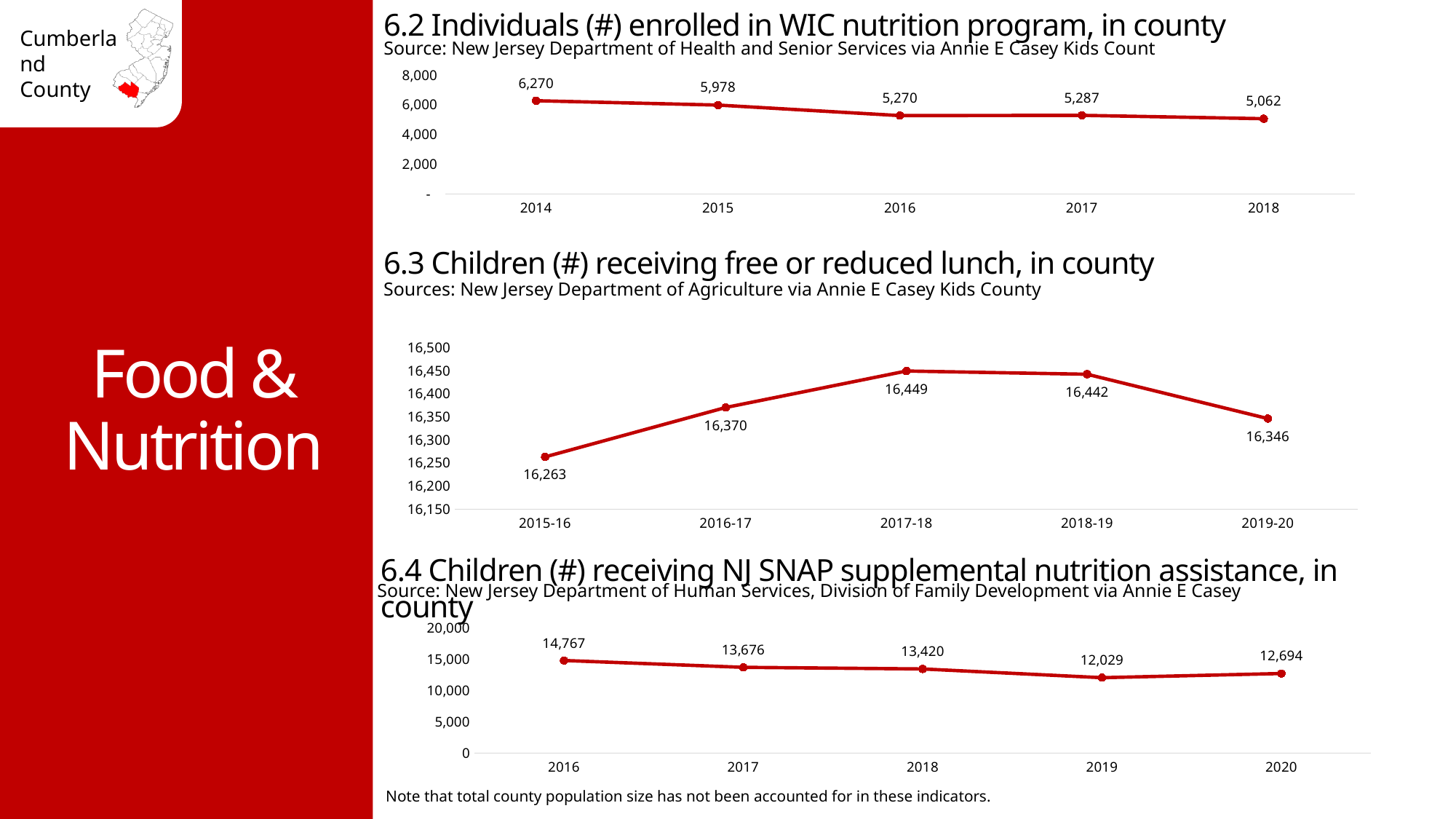
What kind of chart is '6.3 Children (#) receiving free or reduced lunch, in county'? Line chart In the chart '6.2 Individuals (#) enrolled in WIC nutrition program, in county', what is the value for 2014? 6,270 In the chart '6.3 Children (#) receiving free or reduced lunch, in county', what is the value for 2017-18? 16,449 In the chart '6.4 Children (#) receiving NJ SNAP supplemental nutrition assistance, in county', which year has the highest value? 2016 In the chart '6.2 Individuals (#) enrolled in WIC nutrition program, in county', how many years are plotted? 5 In the chart '6.4 Children (#) receiving NJ SNAP supplemental nutrition assistance, in county', what is the difference between the 2017 and 2018 values? 256 In the chart '6.4 Children (#) receiving NJ SNAP supplemental nutrition assistance, in county', what is the value for 2019? 12,029 In the chart '6.3 Children (#) receiving free or reduced lunch, in county', which school year has the lowest value? 2015-16 In the chart '6.2 Individuals (#) enrolled in WIC nutrition program, in county', which year has the lowest value? 2018 In the chart '6.2 Individuals (#) enrolled in WIC nutrition program, in county', what is the difference between the 2014 and 2018 values? 1,208 In the chart '6.4 Children (#) receiving NJ SNAP supplemental nutrition assistance, in county', is the value for 2020 greater or less than 10,000? greater In the chart '6.3 Children (#) receiving free or reduced lunch, in county', is the value for 2016-17 larger than the value for 2019-20? Yes